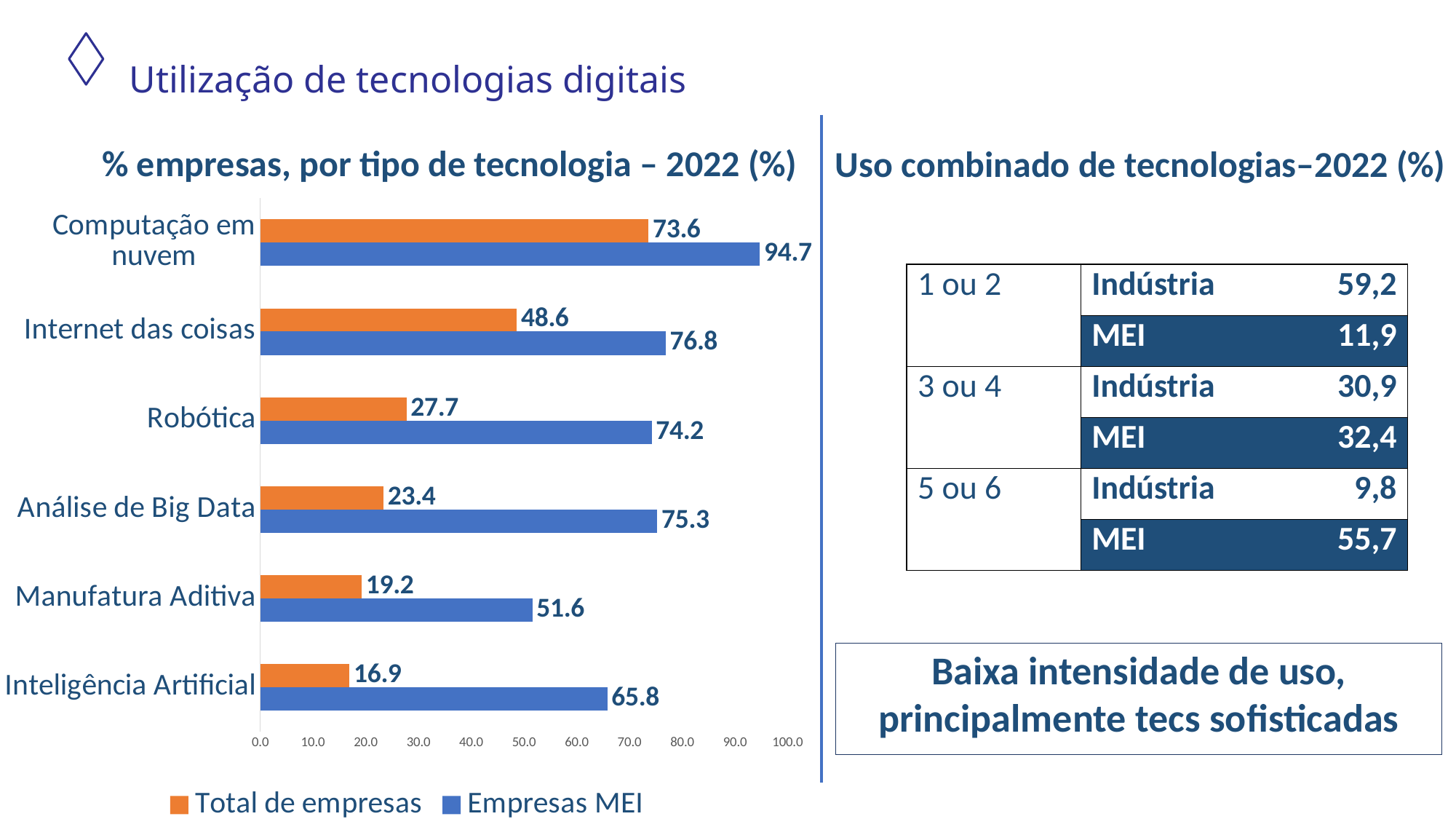
Which technology has the lowest value for Empresas MEI? Manufatura Aditiva What is the value for Total de empresas for Manufatura Aditiva? 19.2 What is the value for Empresas MEI for Robótica? 74.2 Which technology has the lowest value for Total de empresas? Inteligência Artificial What is the value for Empresas MEI for Inteligência Artificial? 65.8 How many series does the chart legend list? 2 How many technology categories are shown in the chart? 6 What is the value for Total de empresas for Computação em nuvem? 73.6 Which technology has the highest value for Empresas MEI? Computação em nuvem Which is larger for Total de empresas: Internet das coisas or Robótica? Internet das coisas What kind of chart is shown on the slide? Bar chart What is the difference between the Empresas MEI and Total de empresas values for Computação em nuvem? 21.1